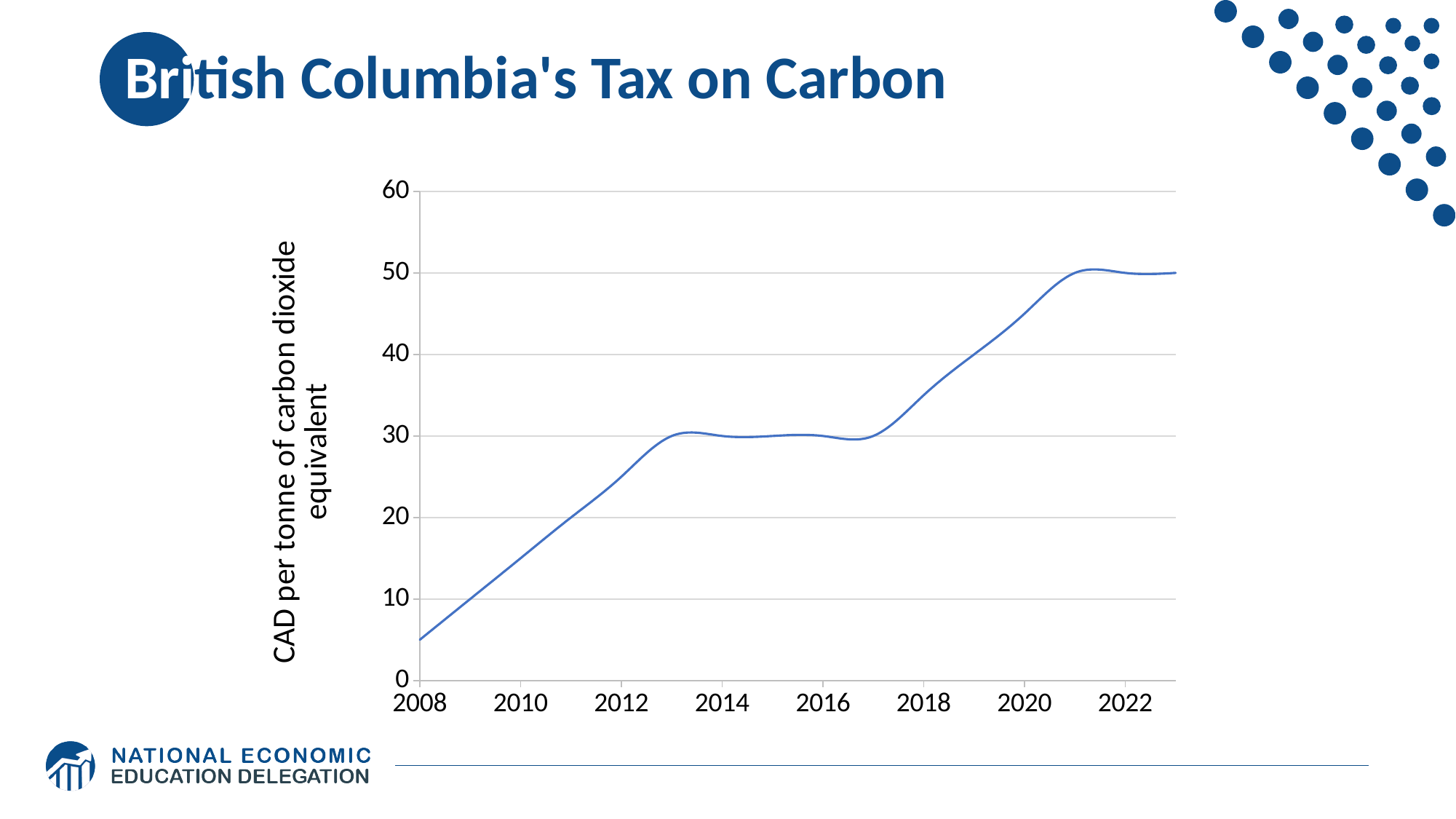
Is the value for 2008 greater or less than 10? less What is the title of the chart on the slide? British Columbia's Tax on Carbon Is the value for 2010 greater or less than 10? greater Which year has the larger carbon tax value, 2012 or 2018? 2018 Which year has the lowest carbon tax value on the chart? 2008 What is the label on the vertical axis of the chart? CAD per tonne of carbon dioxide equivalent Overall, does the carbon tax rise or fall from 2008 to 2023? rise Is the value for 2018 greater or less than 30? greater What kind of chart is shown on the slide? line chart